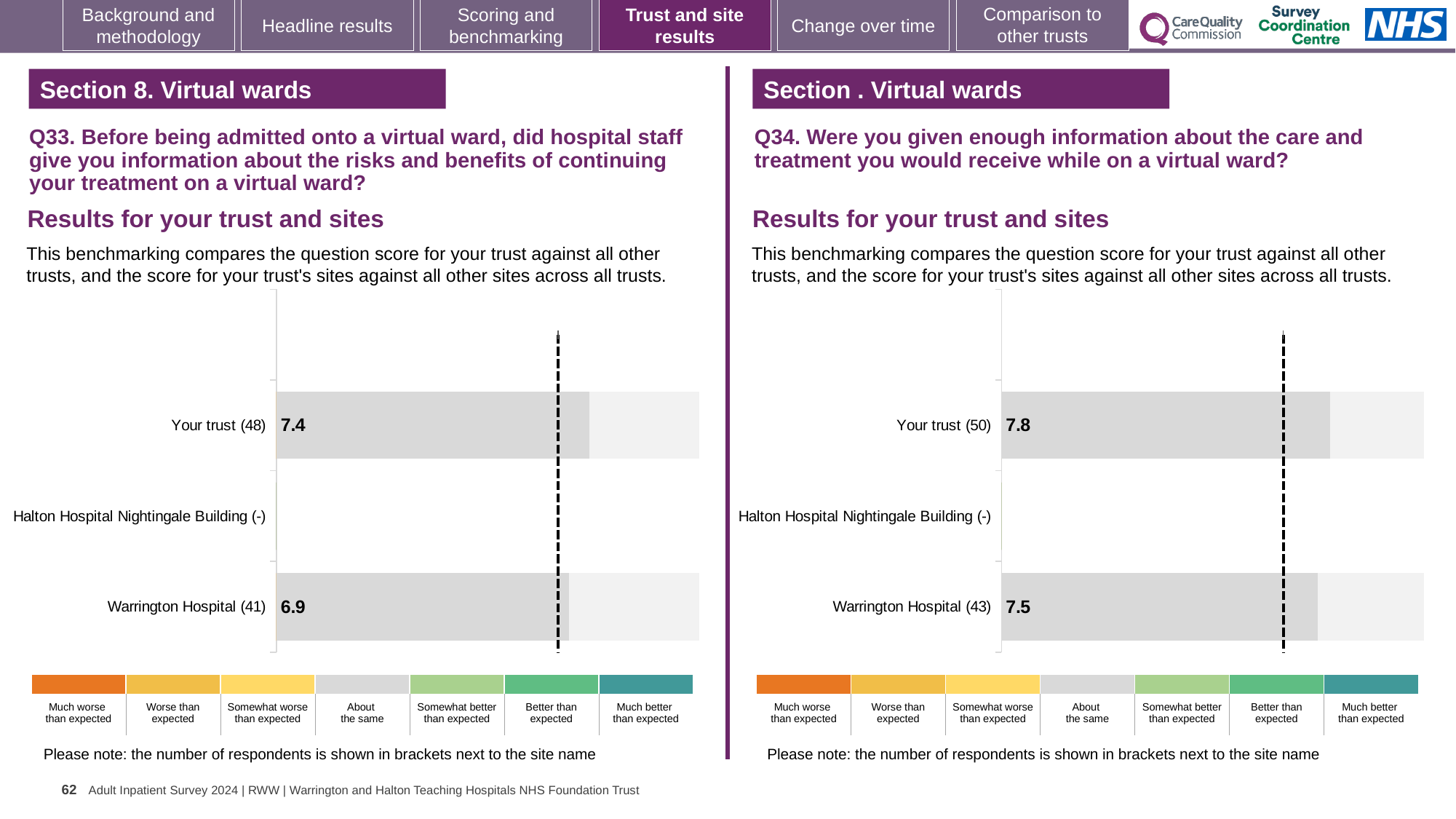
In the Q34 chart on the right, which has the higher score, Your trust or Warrington Hospital? Your trust In the Q33 chart on the left, what is the score for Your trust? 7.4 In the Q34 chart on the right, what is the score for Your trust? 7.8 In the Q33 chart on the left, what is the difference between the Your trust score and the Warrington Hospital score? 0.5 In the Q34 chart on the right, what is the score for Warrington Hospital? 7.5 In the Q34 chart on the right, how many respondents are shown in brackets for Your trust? 50 What type of chart is used in the Q34 chart on the right? Bar chart In the Q34 chart on the right, what is the difference between the Your trust score and the Warrington Hospital score? 0.3 In the Q33 chart on the left, how many respondents are shown in brackets for Warrington Hospital? 41 How many row labels (categories) are listed in the Q33 chart on the left? 3 In the Q33 chart on the left, what is the score for Warrington Hospital? 6.9 In the Q33 chart on the left, which site has no score shown (marked with a dash)? Halton Hospital Nightingale Building